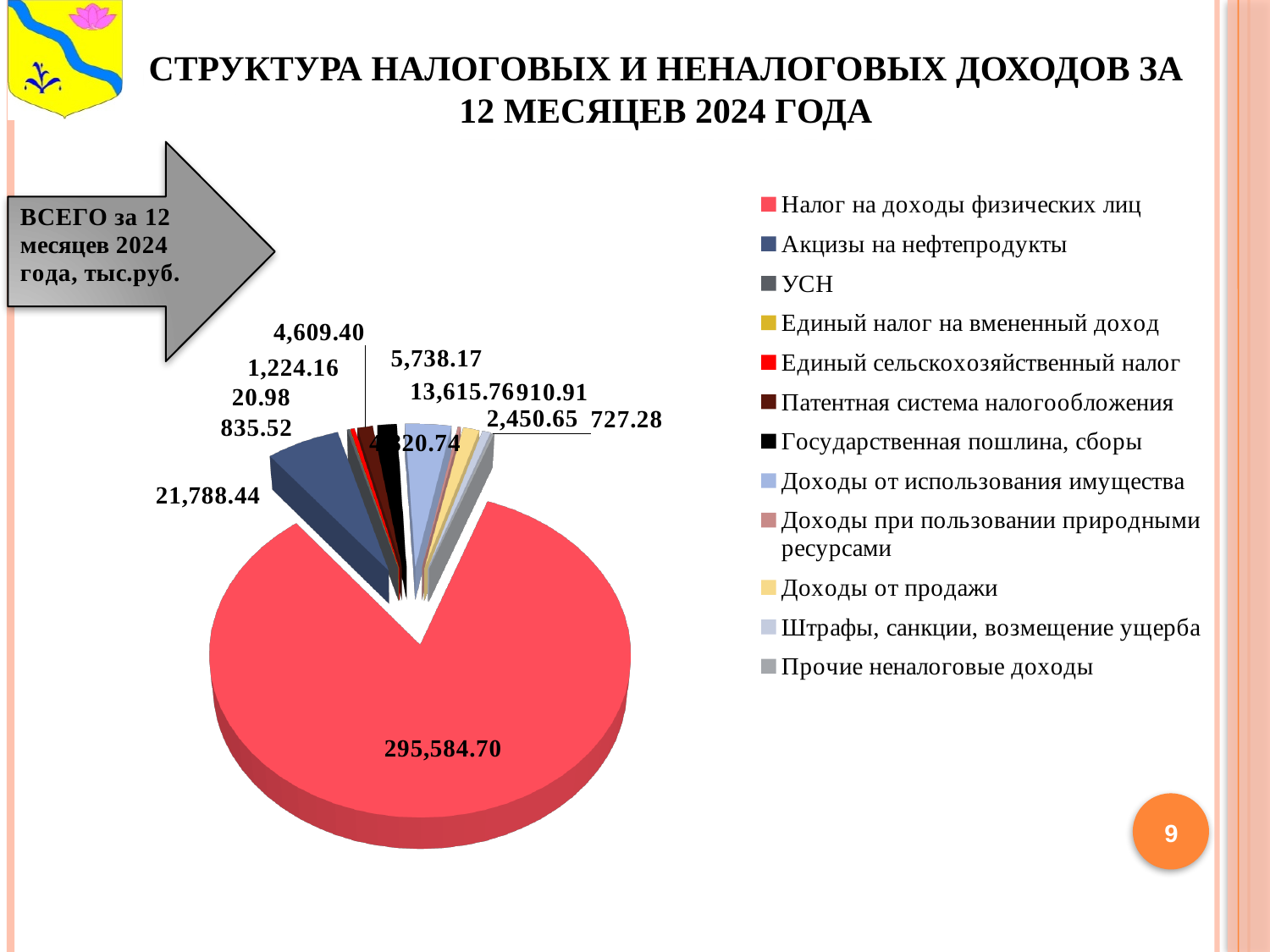
What is the value shown for Налог на доходы физических лиц? 295,584.70 Which is larger: Налог на доходы физических лиц or Акцизы на нефтепродукты? Налог на доходы физических лиц What is the value shown for Акцизы на нефтепродукты? 21,788.44 What is the smallest value printed as a data label on the pie chart? 20.98 What colour is used for Налог на доходы физических лиц in the pie chart? Red What is the difference between the values for Налог на доходы физических лиц and Акцизы на нефтепродукты? 273,796.26 What kind of chart is shown on the slide? Pie chart How many categories does the legend of the pie chart list? 12 Which category has the largest slice in the pie chart? Налог на доходы физических лиц What is the title of the slide containing the pie chart? СТРУКТУРА НАЛОГОВЫХ И НЕНАЛОГОВЫХ ДОХОДОВ ЗА 12 МЕСЯЦЕВ 2024 ГОДА